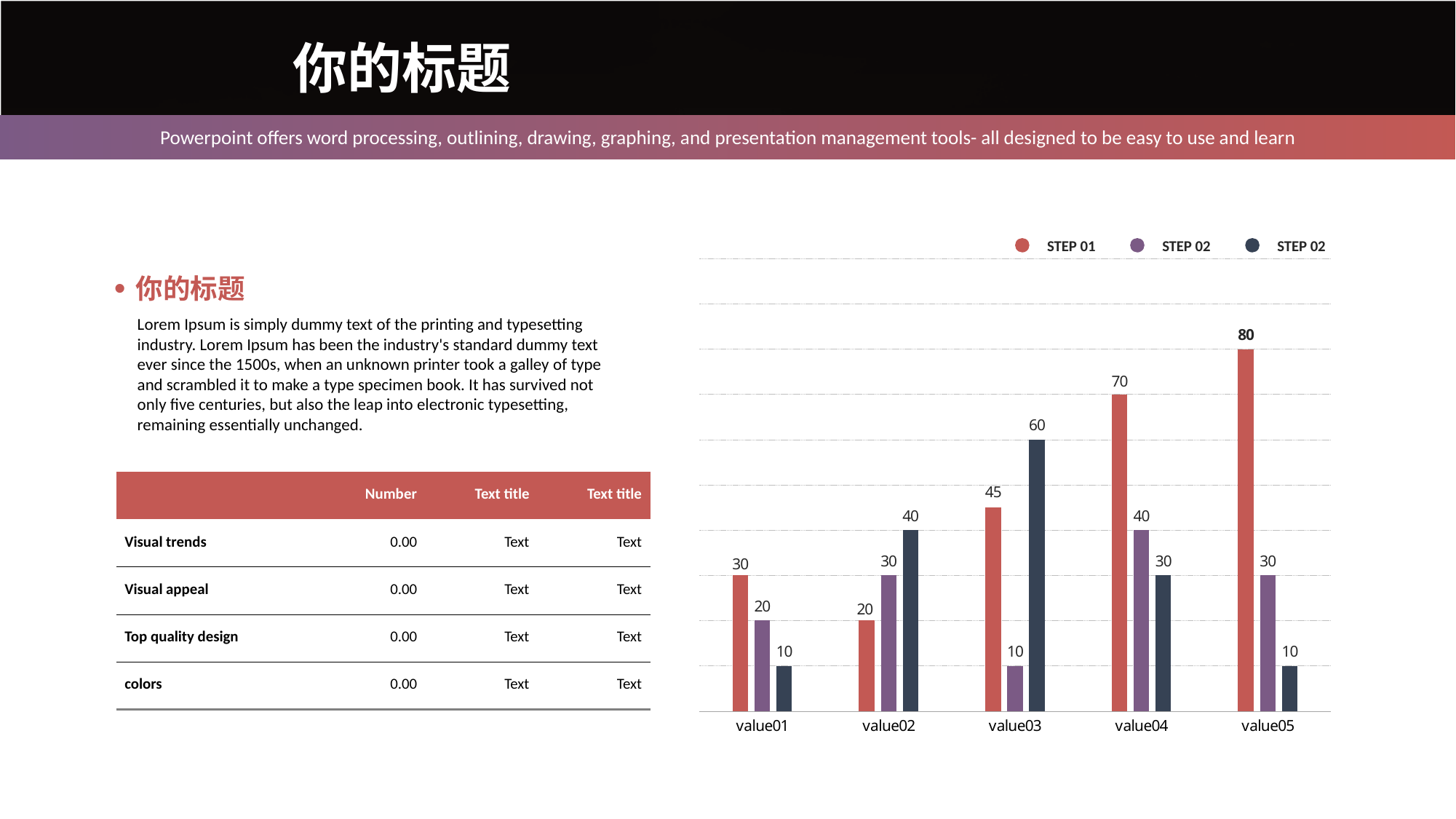
Which category has the highest STEP 01 (red) value? value05 How many series does the chart legend list? 3 What is the value of STEP 01 (red bars) for value05? 80 What is the value of the purple series for value04? 40 Do the STEP 01 (red) values rise or fall from value02 to value05? rise What type of chart is shown on the slide? bar chart What is the difference between the STEP 01 (red) values for value04 and value01? 40 Which category has the lowest value for the dark navy series? value01 and value05 (both 10) What is the value of STEP 01 (red bars) for value02? 20 How many categories are shown on the x axis of the chart? 5 For value03, which is larger: the STEP 01 (red) bar or the dark navy bar? the dark navy bar What is the value of the dark navy series for value03? 60